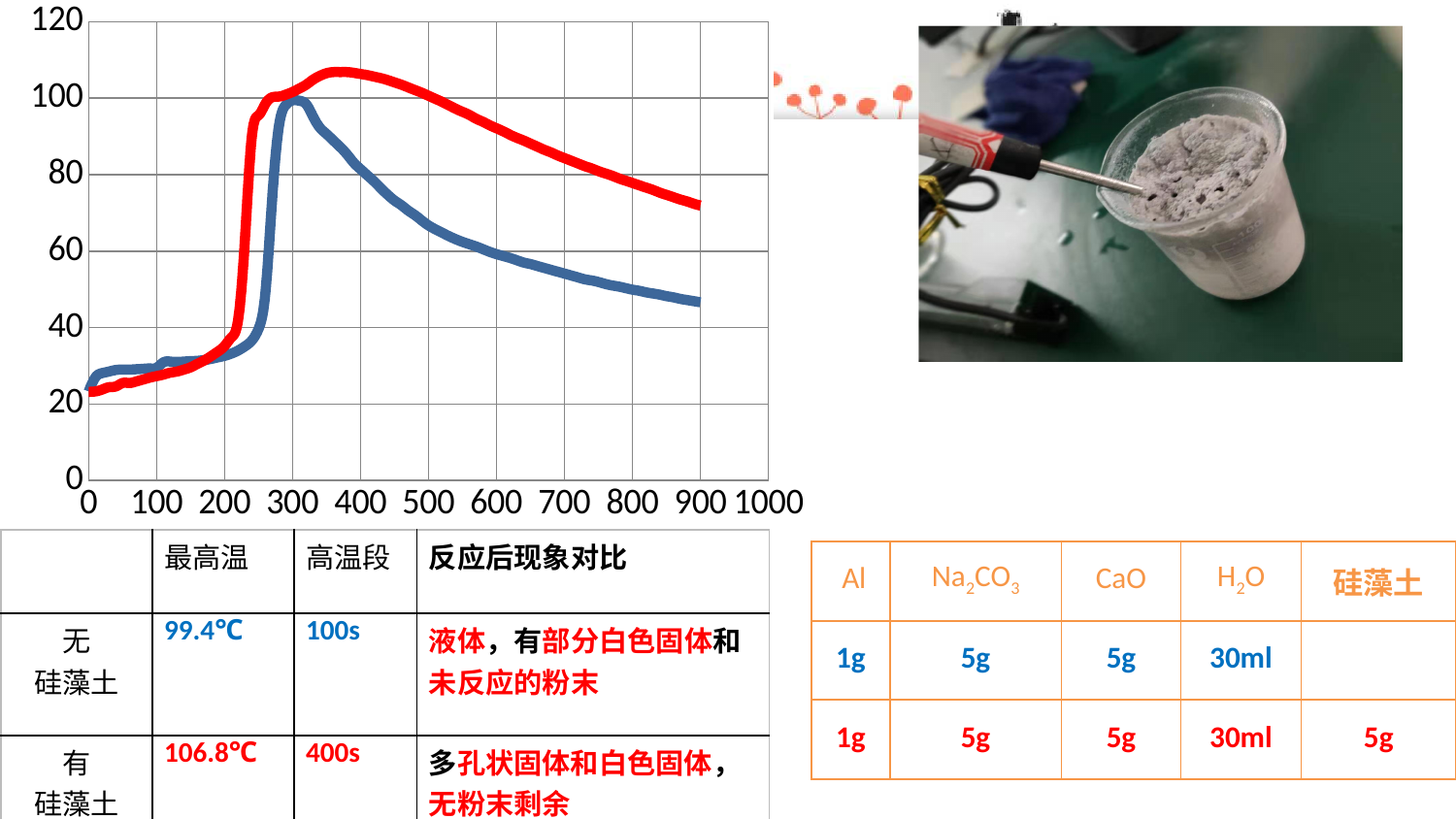
At x = 900, which line has the higher value, red or blue? red Is the peak value of the red line greater or less than 100? greater What is the largest tick label shown on the x axis of the chart? 1000 Is the value of the blue line at x = 900 greater or less than 60? less Which line reaches the higher peak value, the red line or the blue line? red line Is the value of the red line at x = 900 greater or less than 60? greater What is the highest value shown on the y axis of the chart? 120 Between x = 400 and x = 900, do the values of the red line rise or fall? fall How many lines are plotted on the chart? 2 What kind of chart is shown on the slide? line chart